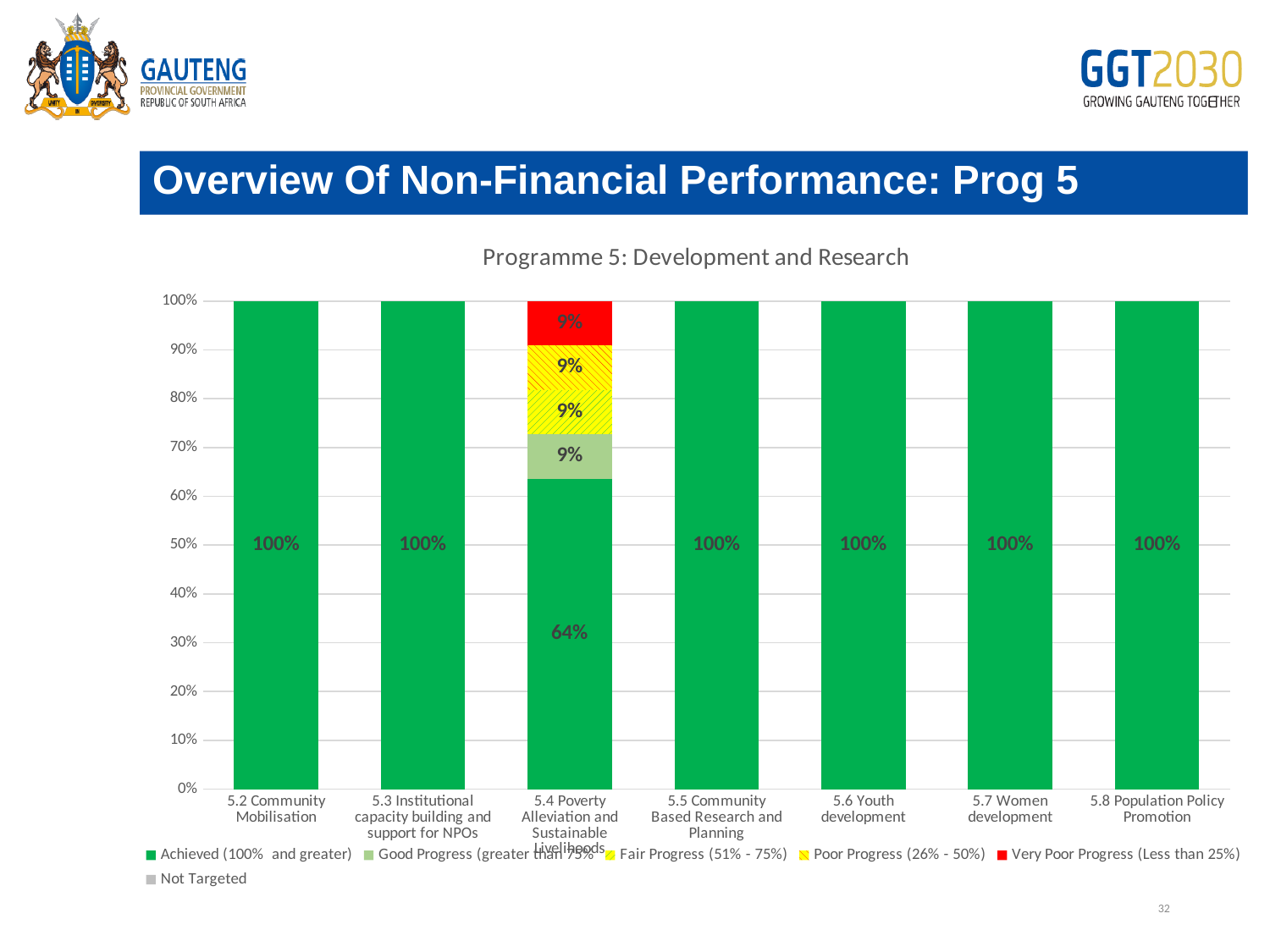
What is the Achieved (100% and greater) value for 5.6 Youth development? 100% What is the difference between the Achieved value for 5.2 Community Mobilisation and the Achieved value for 5.4 Poverty Alleviation and Sustainable Livelihoods? 36% What is the title of the chart? Programme 5: Development and Research What is the Very Poor Progress (Less than 25%) value for 5.4 Poverty Alleviation and Sustainable Livelihoods? 9% How many categories (sub-programmes) are shown on the x axis? 7 What is the total of the stacked bar for 5.4 Poverty Alleviation and Sustainable Livelihoods? 100% Which legend entry is shown in red? Very Poor Progress (Less than 25%) What type of chart is shown on the slide? Stacked bar chart Which is larger: the Achieved value for 5.8 Population Policy Promotion or the Achieved value for 5.4 Poverty Alleviation and Sustainable Livelihoods? 5.8 Population Policy Promotion How many series does the legend list? 6 Which category has the lowest Achieved (100% and greater) value? 5.4 Poverty Alleviation and Sustainable Livelihoods What is the Achieved (100% and greater) value for 5.4 Poverty Alleviation and Sustainable Livelihoods? 64%